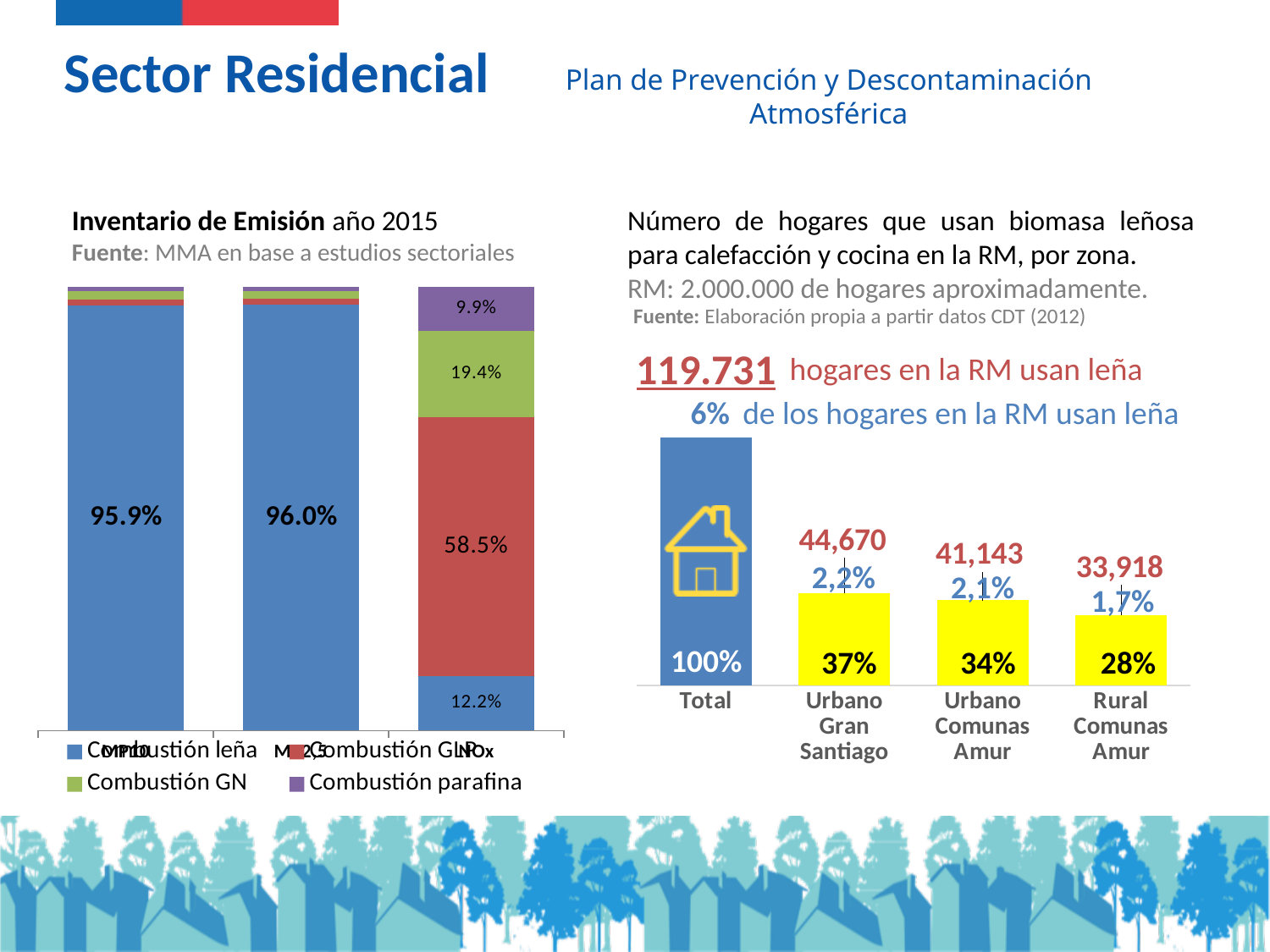
In the right chart (hogares que usan biomasa leñosa), which zone other than Total has the lowest number of households? Rural Comunas Amur What kind of chart is the left chart (Inventario de Emisión año 2015)? Stacked bar chart In the left chart (Inventario de Emisión año 2015), which fuel contributes the largest share of the NOx bar? Combustión GLP In the right chart (hogares que usan biomasa leñosa), how many categories are shown on the x axis? 4 In the left chart (Inventario de Emisión año 2015), how many series does the legend list? 4 In the left chart (Inventario de Emisión año 2015), what share does Combustión parafina contribute to the NOx bar? 9.9% In the right chart (hogares que usan biomasa leñosa), what is the number of households for Urbano Gran Santiago? 44,670 In the left chart (Inventario de Emisión año 2015), what share does Combustión GLP contribute to the NOx bar? 58.5% In the left chart (Inventario de Emisión año 2015), what is the difference between the Combustión GN and Combustión parafina shares of the NOx bar? 9.5% In the right chart (hogares que usan biomasa leñosa), what is the difference in households between Urbano Gran Santiago and Urbano Comunas Amur? 3,527 In the left chart (Inventario de Emisión año 2015), what share does Combustión leña contribute to the NOx bar? 12.2% In the right chart (hogares que usan biomasa leñosa), what percentage is shown for Rural Comunas Amur? 28%